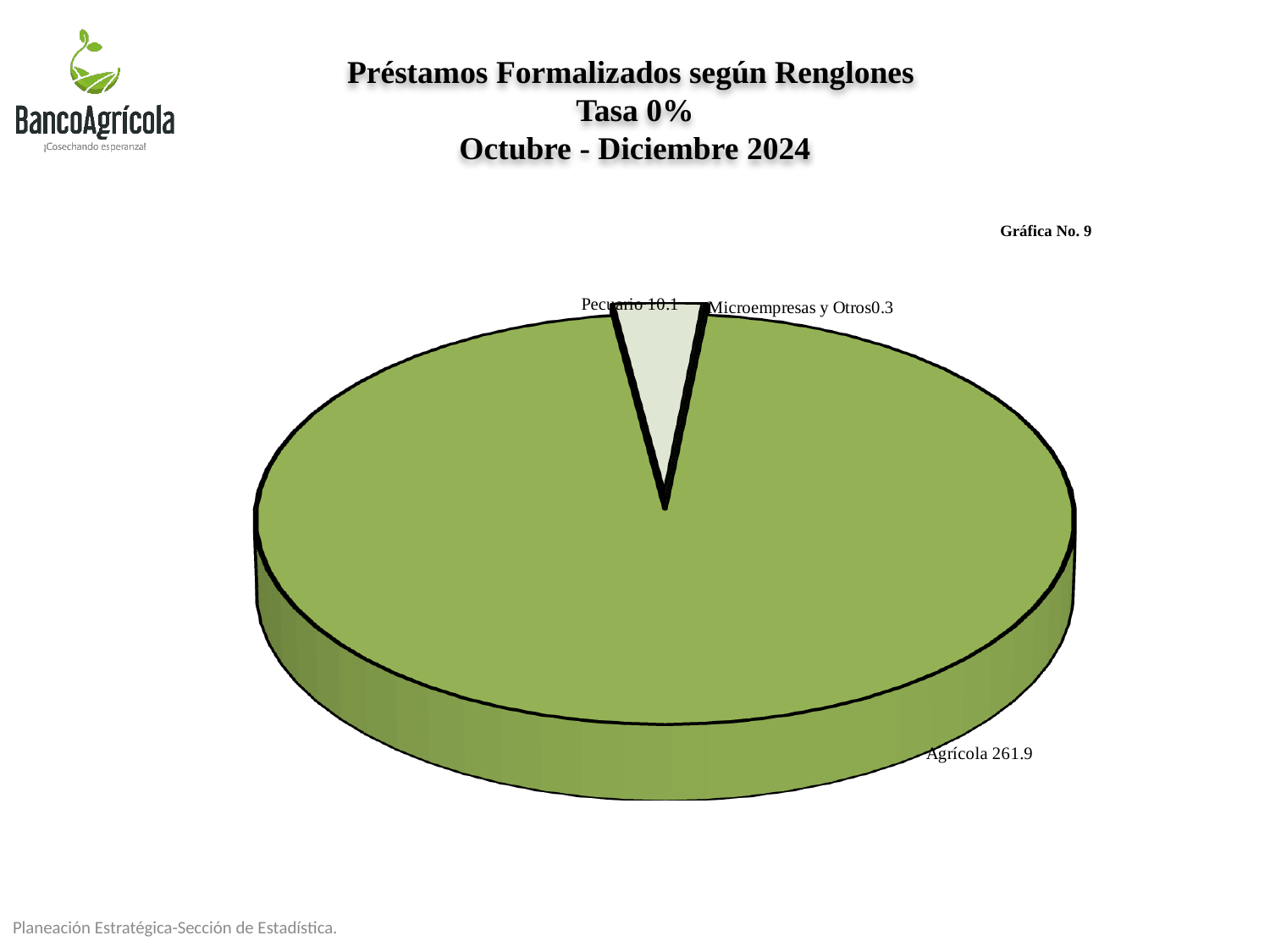
What type of chart is shown on the slide? Pie chart Which category has the largest slice of the pie? Agrícola What is the difference between the values for Agrícola and Pecuario? 251.8 What is the value for Agrícola? 261.9 Which category has the smallest slice of the pie? Microempresas y Otros What is the value for Microempresas y Otros? 0.3 How many categories are shown in the pie chart? 3 What is the total of all the slices in the pie chart? 272.3 What is the value for Pecuario? 10.1 Which is larger, the value for Pecuario or the value for Microempresas y Otros? Pecuario What is the difference between the values for Pecuario and Microempresas y Otros? 9.8 What period does the chart title say the data covers? Octubre - Diciembre 2024